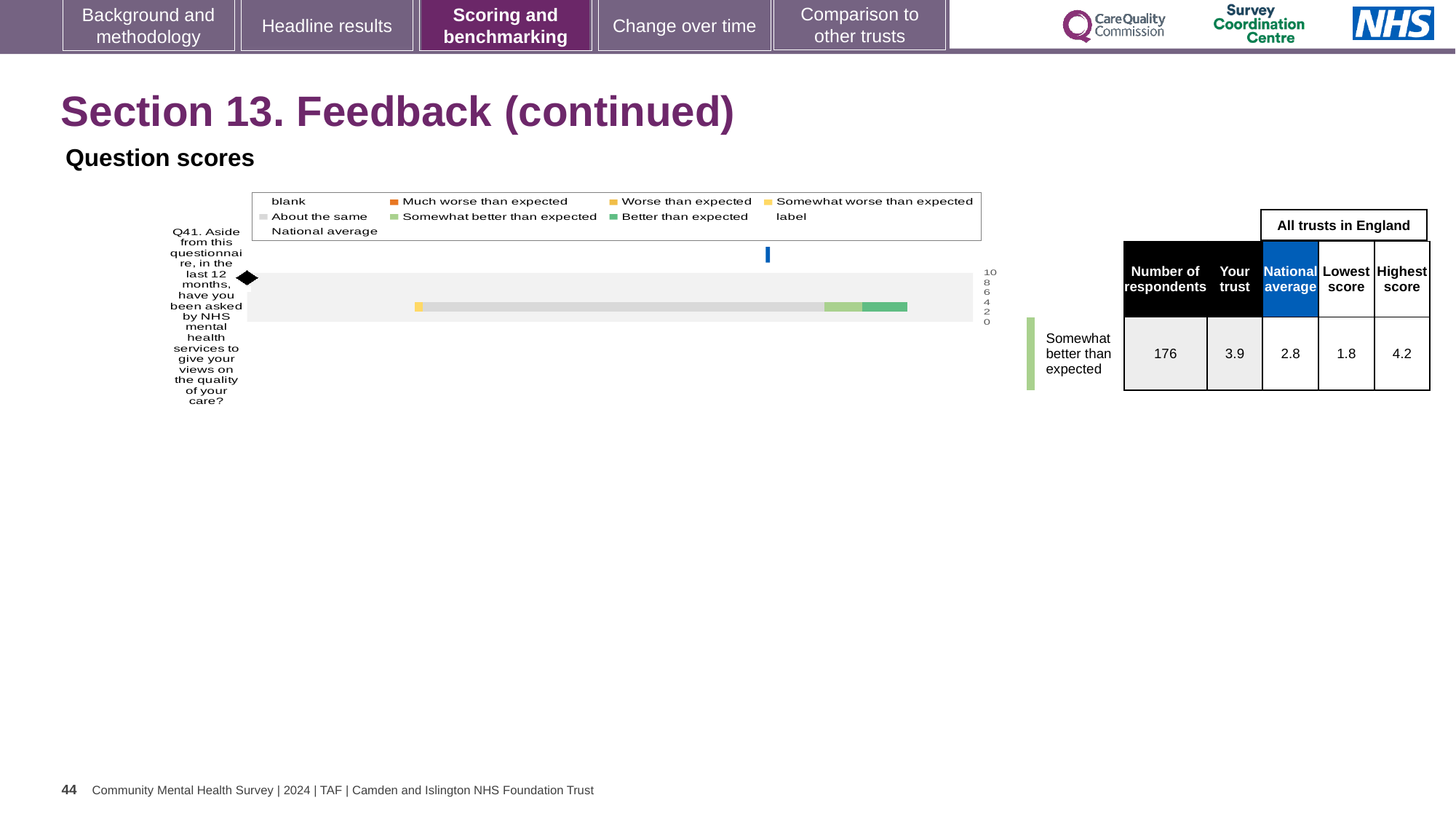
What is the difference between the highest and lowest scores among all trusts in England for Q41? 2.4 How many questions (categories) are plotted in the chart? 1 According to the table beside the chart, what is the national average score for Q41? 2.8 Which is larger for Q41: the 'Your trust' score or the national average? Your trust What benchmark rating is given for Q41 next to the chart? Somewhat better than expected How many respondents answered Q41, according to the table beside the chart? 176 Which question number is plotted in the chart? Q41 According to the table beside the chart, what is the lowest score among all trusts in England for Q41? 1.8 According to the table beside the chart, what is the 'Your trust' score for Q41? 3.9 What kind of chart is shown on the slide? bar chart According to the table beside the chart, what is the highest score among all trusts in England for Q41? 4.2 What is the difference between the 'Your trust' score and the national average for Q41? 1.1